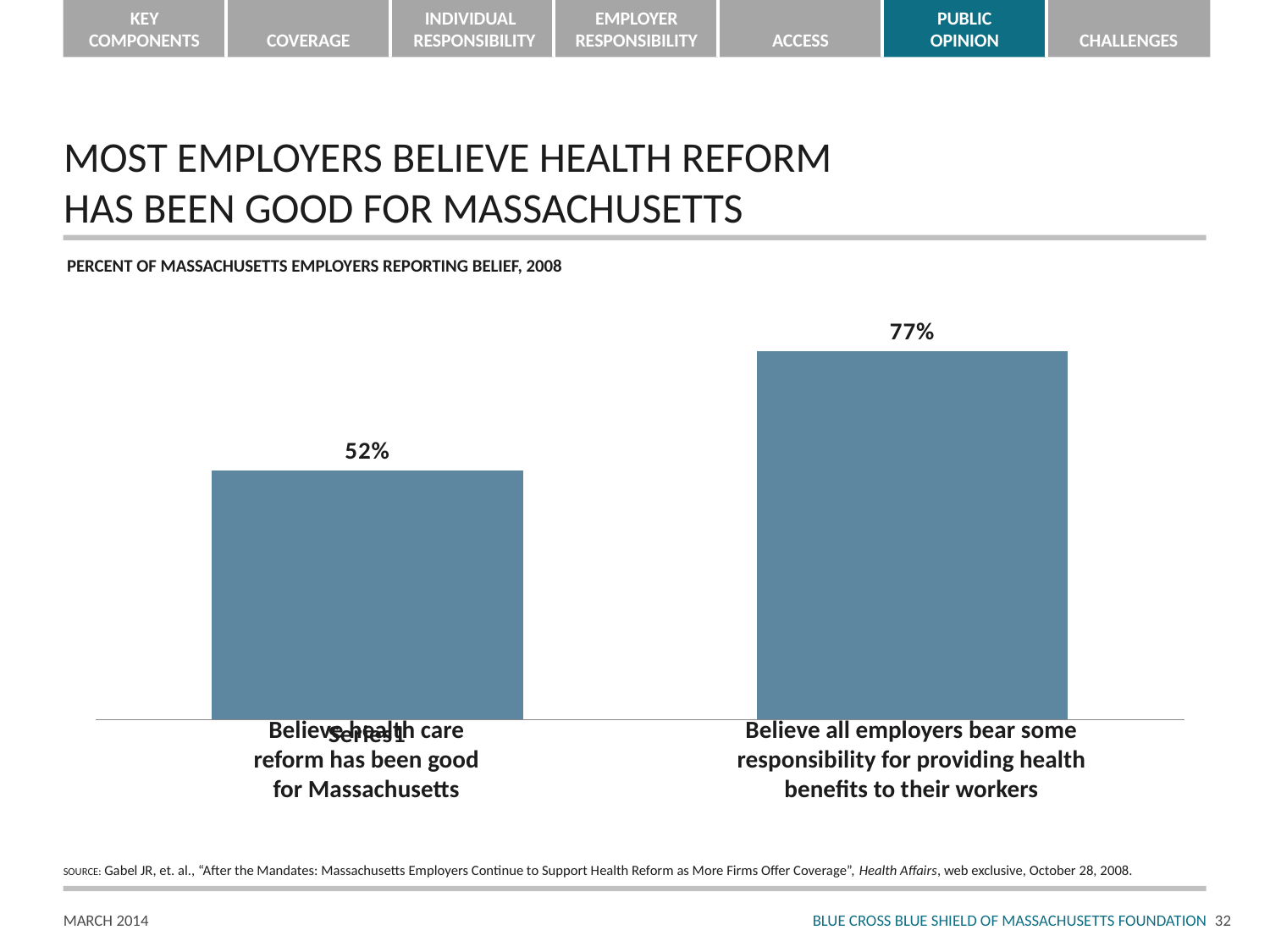
What kind of chart is shown on the slide? bar chart What percent of Massachusetts employers believe health care reform has been good for Massachusetts? 52% Which belief has the higher percentage of employers reporting it? Believe all employers bear some responsibility for providing health benefits to their workers What percent of Massachusetts employers believe all employers bear some responsibility for providing health benefits to their workers? 77% How many bars are shown in the chart? 2 Which belief has the lower percentage of employers reporting it? Believe health care reform has been good for Massachusetts What is the difference in percentage points between the two bars? 25 What year does the chart's data refer to? 2008 Is the value for employers believing health care reform has been good for Massachusetts larger or smaller than the value for employers believing all employers bear some responsibility for providing health benefits? smaller What is the subtitle of the chart? PERCENT OF MASSACHUSETTS EMPLOYERS REPORTING BELIEF, 2008